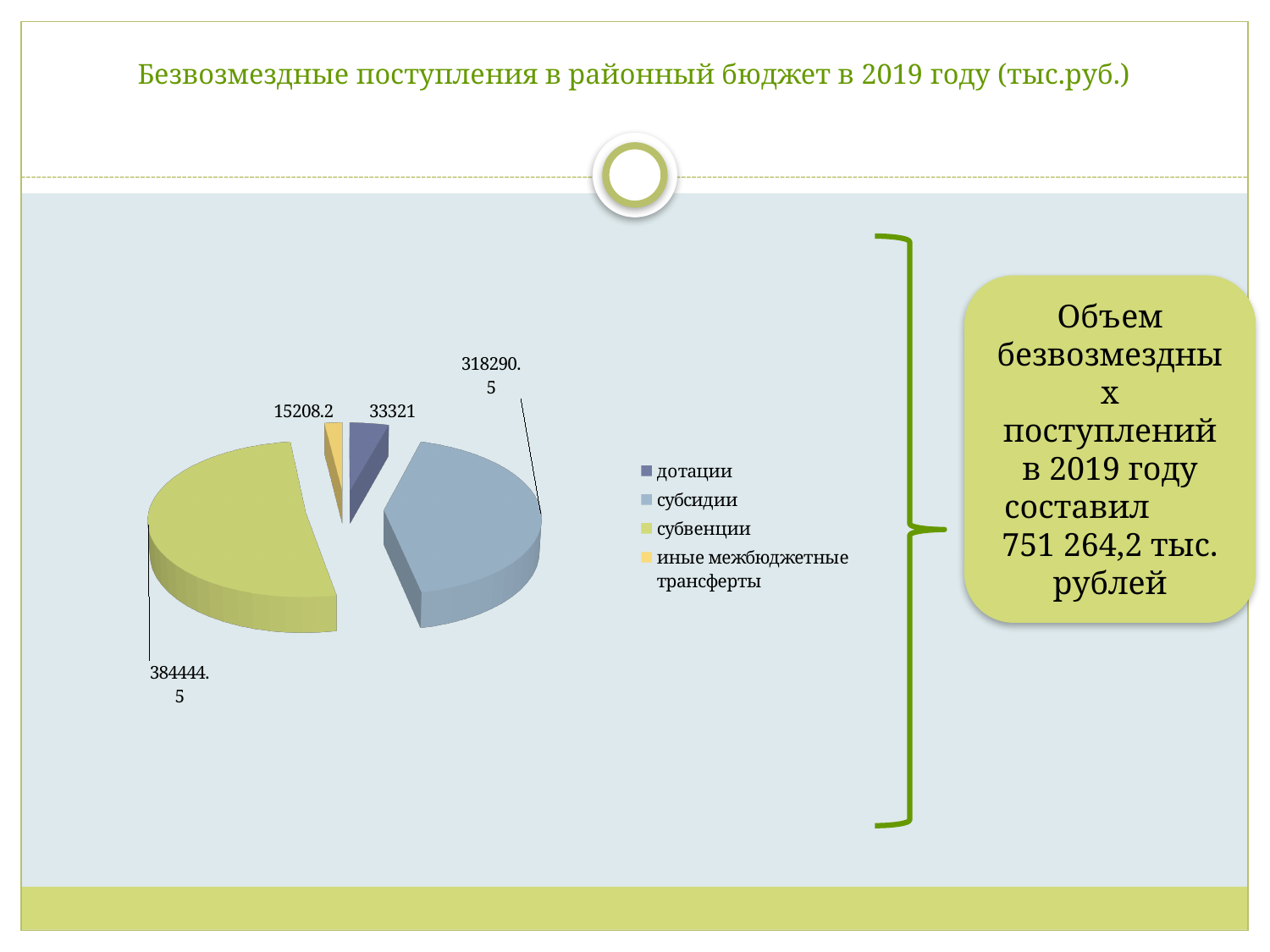
What is the difference between the values for дотации and иные межбюджетные трансферты? 18112.8 What is the title of the chart on the slide? Безвозмездные поступления в районный бюджет в 2019 году (тыс.руб.) Which category has the largest slice in the pie chart? субвенции How many categories does the pie chart show? 4 What is the value for субвенции in the pie chart? 384444.5 What is the value for иные межбюджетные трансферты in the pie chart? 15208.2 Which category has the smallest slice in the pie chart? иные межбюджетные трансферты Which is larger, the value for дотации or the value for иные межбюджетные трансферты? дотации What is the value for субсидии in the pie chart? 318290.5 What is the difference between the values for субвенции and субсидии? 66154 What type of chart is shown on the slide? pie chart What is the value for дотации in the pie chart? 33321